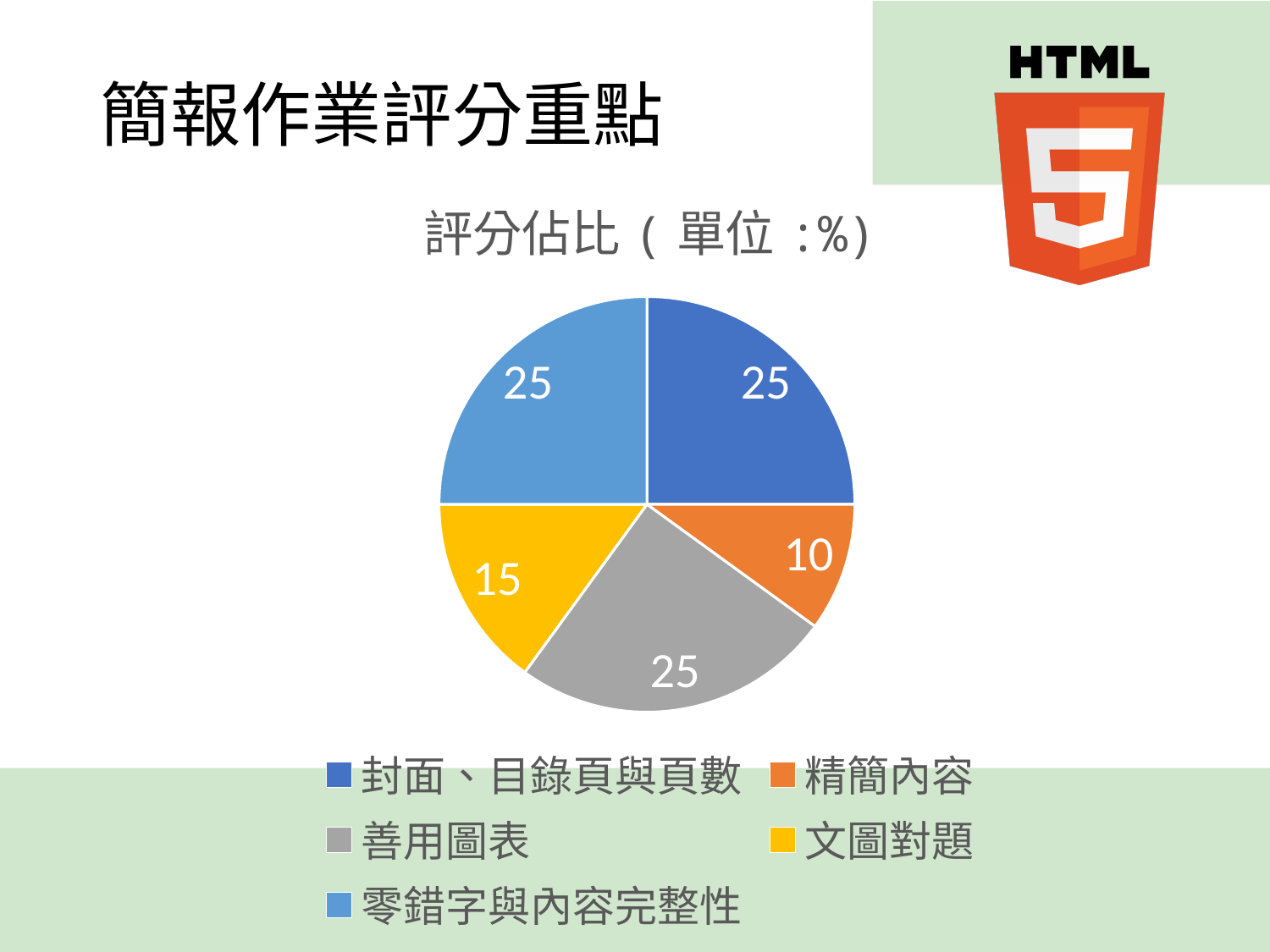
What share of the pie does 文圖對題 represent? 15% What is the value for 文圖對題? 15 What is the title of the chart? 評分佔比（單位：%） What is the difference between the values for 封面、目錄頁與頁數 and 精簡內容? 15 What is the value for 精簡內容? 10 Which colour represents 善用圖表 in the legend? gray What kind of chart is shown on the slide? pie chart What is the value for 零錯字與內容完整性? 25 Which category has the smallest slice? 精簡內容 What is the value for 善用圖表? 25 Which is larger, the value for 文圖對題 or the value for 精簡內容? 文圖對題 How many slices does the pie chart have? 5